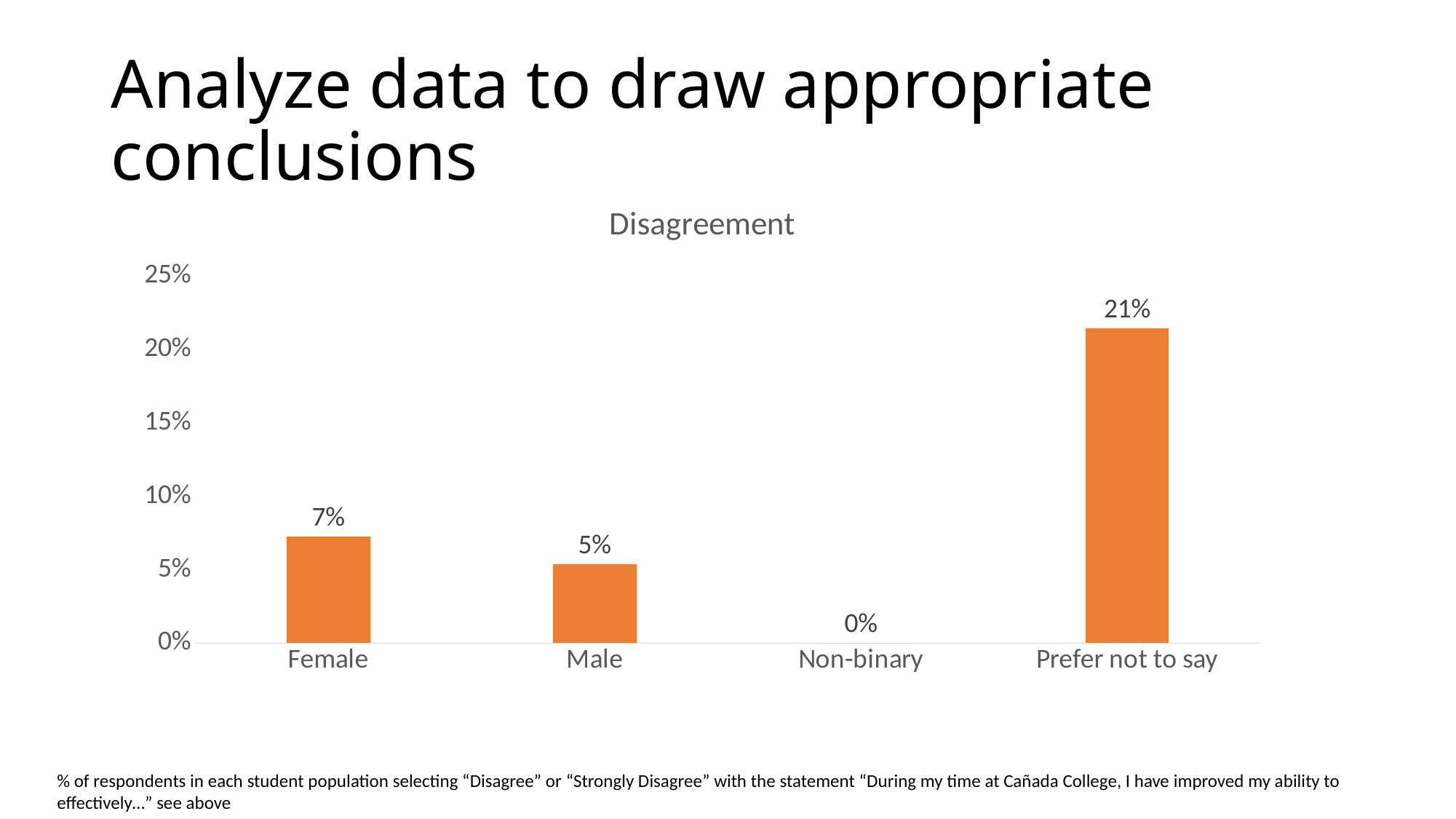
What is the value for Male? 5% What is the value for Female? 7% Which category has the highest value? Prefer not to say What is the value for Non-binary? 0% Is the value for Prefer not to say greater or less than 20%? greater What is the value for Prefer not to say? 21% What kind of chart is shown on the slide? Bar chart What is the difference between the values for Prefer not to say and Female? 14% How many categories are shown on the x axis? 4 Which category has the lowest value? Non-binary Which is larger, the value for Female or the value for Male? Female What is the title of the chart? Disagreement